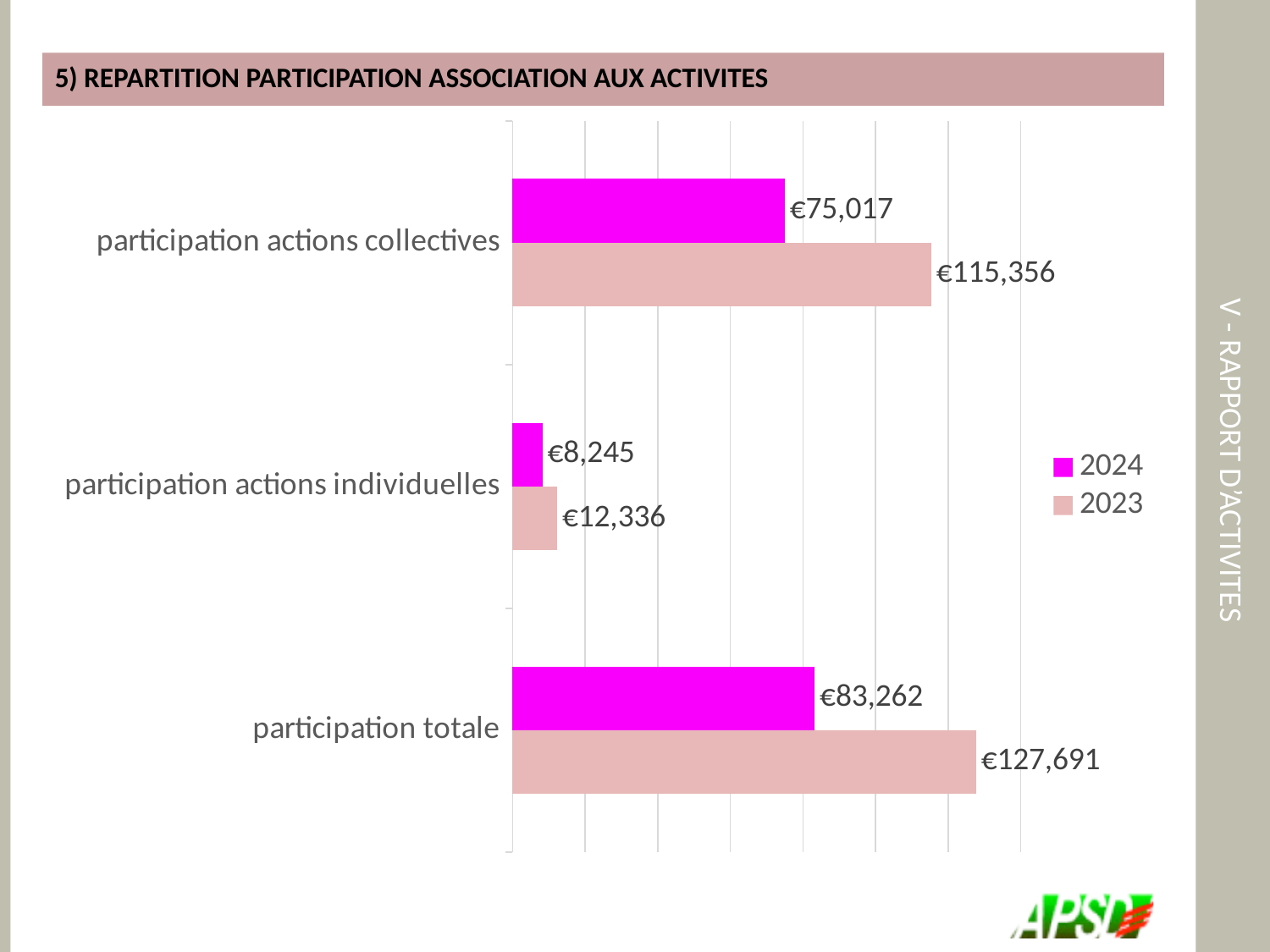
What is the difference between the 2023 and 2024 values for participation actions collectives? €40,339 Which category has the highest value for the 2023 series? participation totale What is the difference between the 2023 and 2024 values for participation totale? €44,429 What is the value for participation actions individuelles in 2024? €8,245 Which category has the lowest value for the 2024 series? participation actions individuelles What kind of chart is shown on the slide? bar chart What is the value for participation totale in 2023? €127,691 How many categories are shown on the chart? 3 What is the value for participation actions collectives in 2023? €115,356 How many series does the legend list? 2 For participation actions individuelles, which year has the larger value, 2023 or 2024? 2023 What is the value for participation actions collectives in 2024? €75,017